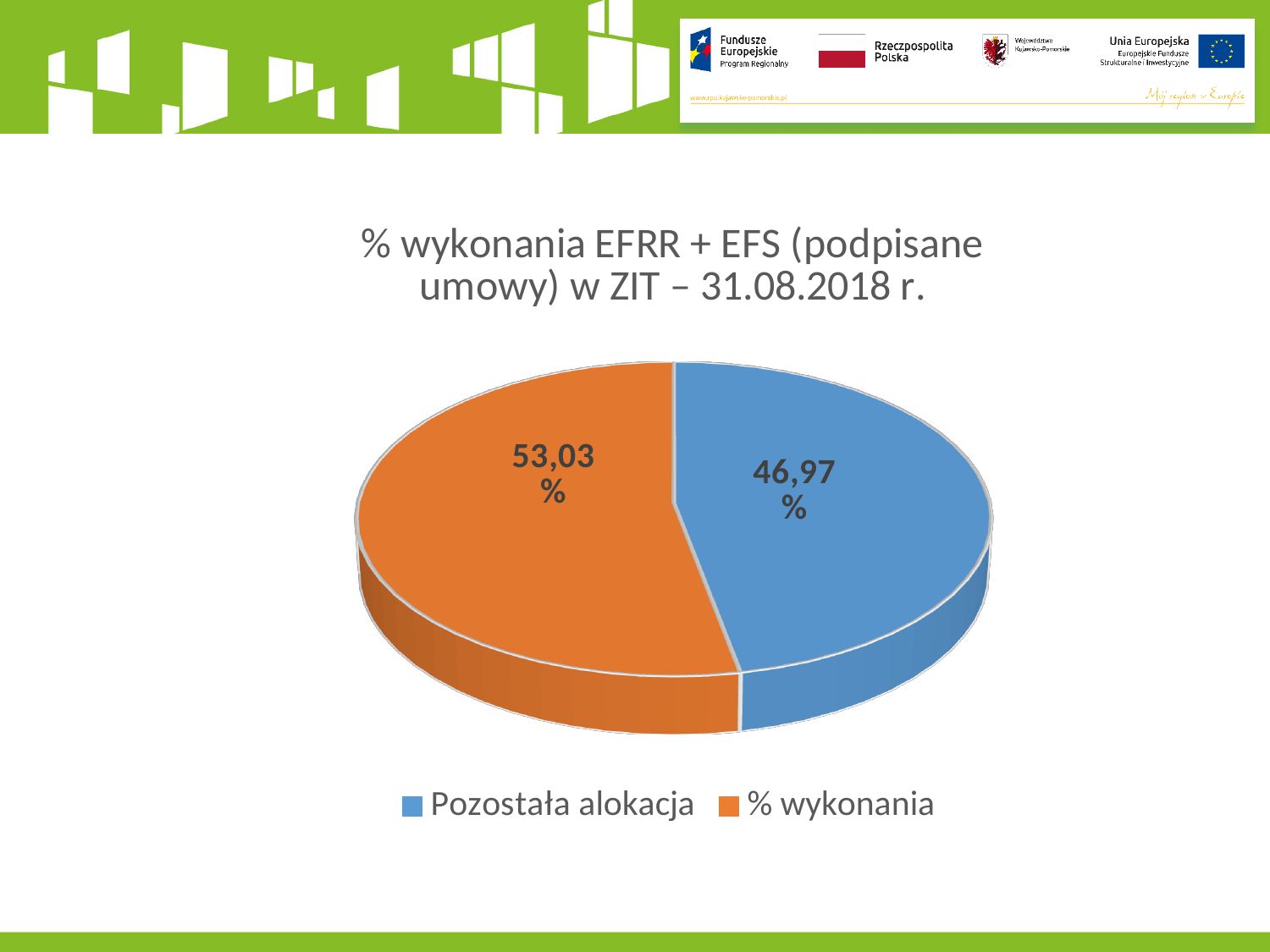
What is the difference between the "% wykonania" and "Pozostała alokacja" slices? 6,06% Which is larger, "% wykonania" or "Pozostała alokacja"? % wykonania What is the value of the "% wykonania" slice? 53,03% What colour is the "Pozostała alokacja" slice? Blue What is the value of the "Pozostała alokacja" slice? 46,97% Which slice is the smallest? Pozostała alokacja Which slice is the largest? % wykonania What type of chart is shown on the slide? Pie chart What is the title of the chart? % wykonania EFRR + EFS (podpisane umowy) w ZIT – 31.08.2018 r. How many slices does the pie chart have? 2 How many entries does the legend list? 2